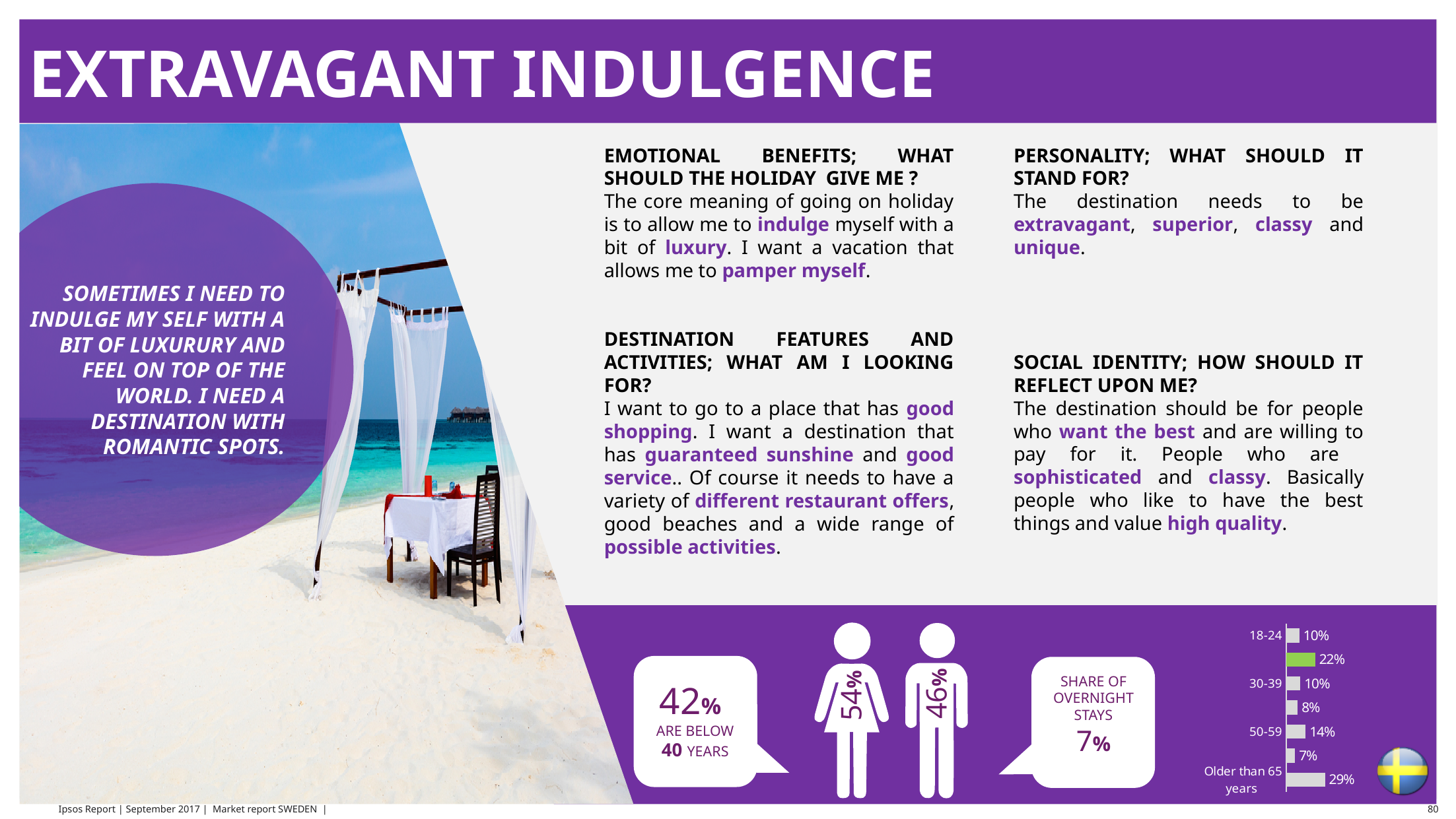
In the bar chart at the bottom right, what is the difference between the value for 50-59 and the value for 18-24? 4% What is the value for the 50-59 age group in the bar chart at the bottom right? 14% What is the value for the 30-39 age group in the bar chart at the bottom right? 10% What is the value for the 'Older than 65 years' group in the bar chart at the bottom right? 29% What kind of chart is shown at the bottom right of the slide? Bar chart Which age group has the highest value in the bar chart at the bottom right? Older than 65 years How many bars are shown in the bar chart at the bottom right? 7 In the bar chart at the bottom right, which is larger: the value for 'Older than 65 years' or the value for 18-24? Older than 65 years What is the value for the 18-24 age group in the bar chart at the bottom right? 10% In the bar chart at the bottom right, what value is shown on the bar highlighted in green? 22% In the bar chart at the bottom right, which is larger: the value for 50-59 or the value for 30-39? 50-59 In the bar chart at the bottom right, what is the difference between the value for 'Older than 65 years' and the value for 50-59? 15%